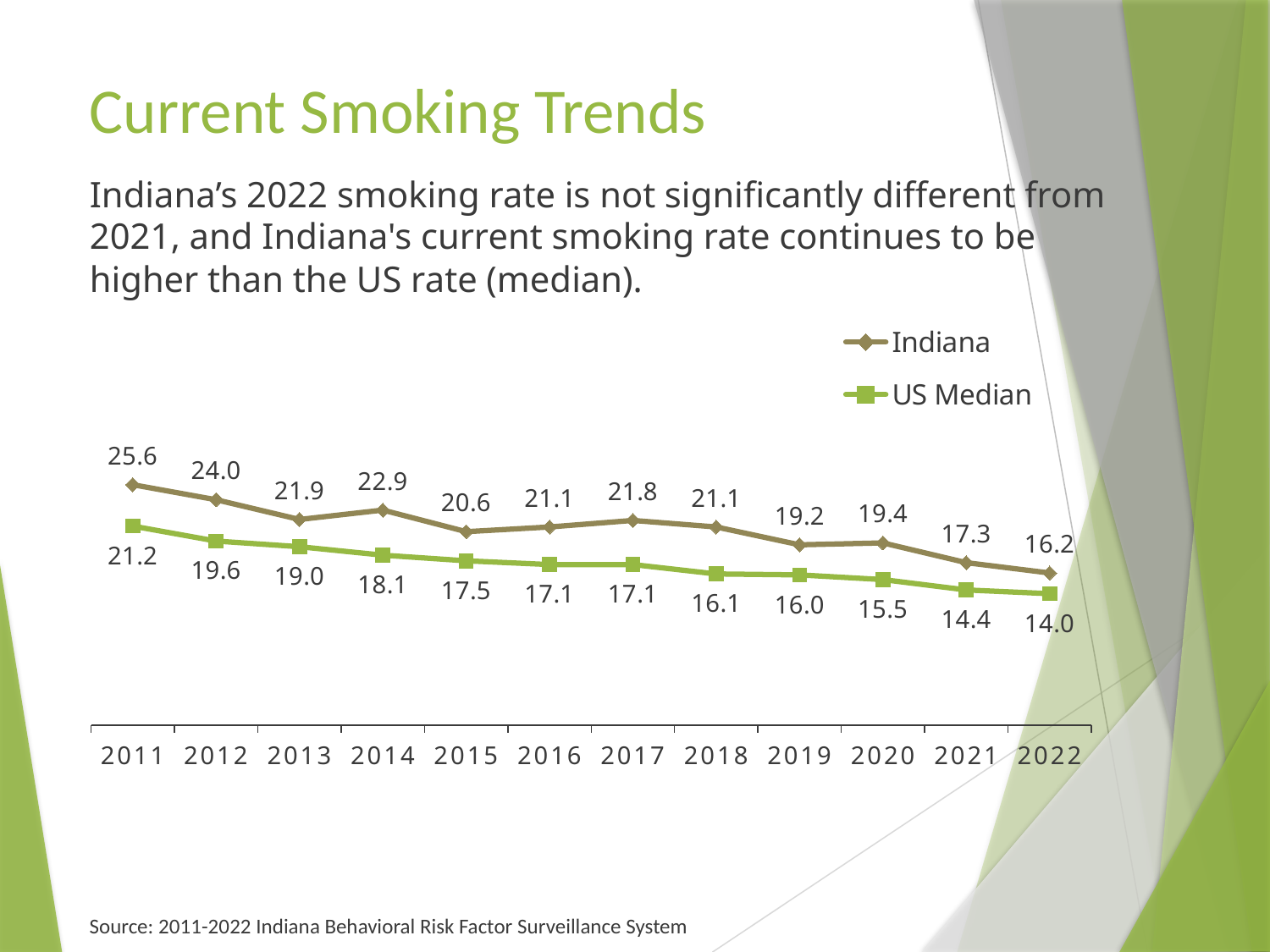
In which year is the Indiana series at its highest? 2011 Which is larger in 2020, the Indiana value or the US Median value? Indiana What is the US Median smoking rate for 2022? 14.0 What is the difference between the Indiana and US Median values in 2022? 2.2 What is the US Median value for 2014? 18.1 What is the Indiana smoking rate for 2011? 25.6 How many series does the legend list? 2 What kind of chart is shown on the slide? Line chart What is the difference between the Indiana values for 2011 and 2022? 9.4 In which year is the US Median series at its lowest? 2022 How many years are shown on the x axis? 12 What is the Indiana value for 2017? 21.8